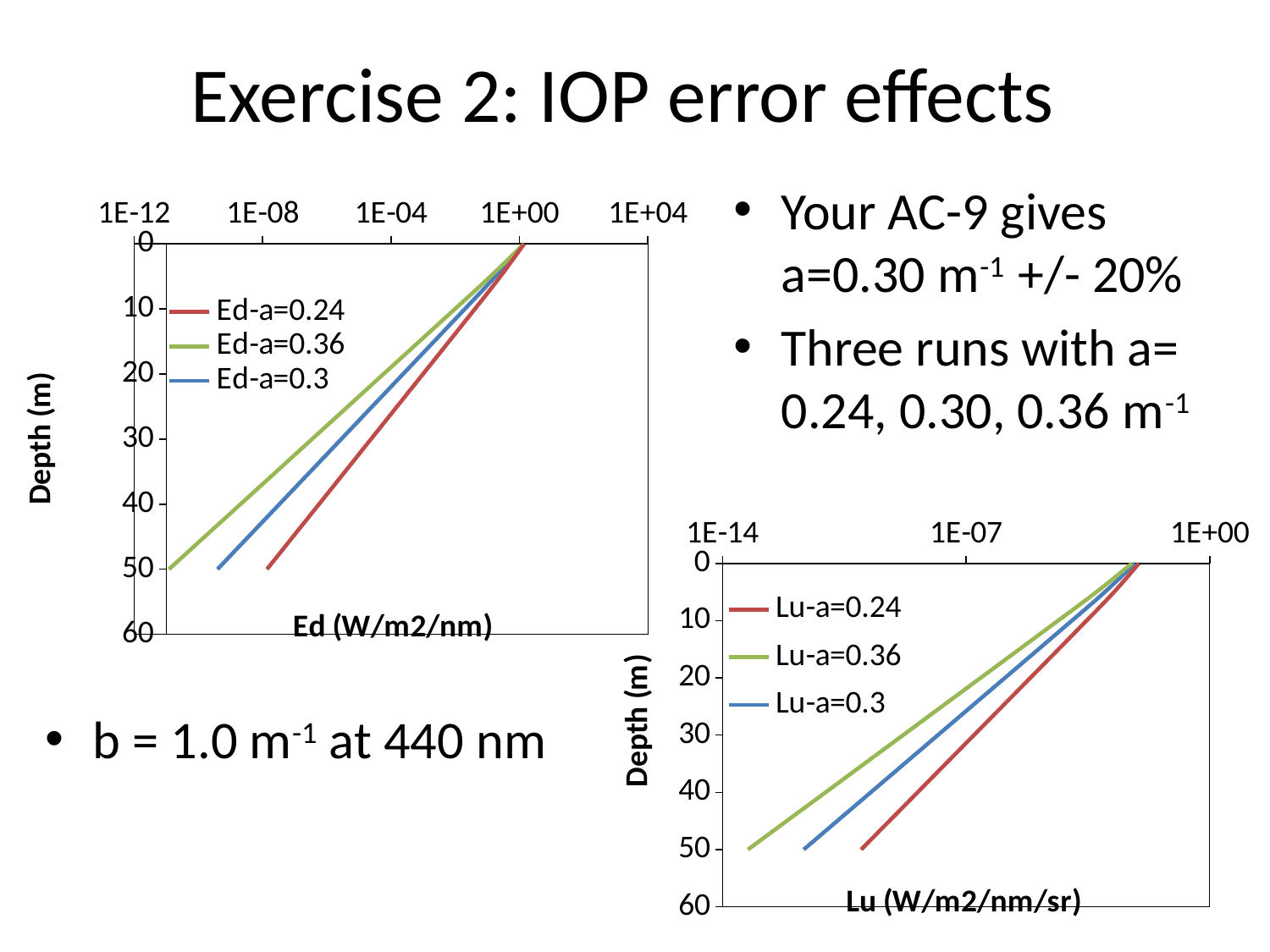
What is the y-axis title of the right chart (Lu)? Depth (m) In the left chart (Ed), which series has the lowest Ed value at 50 m depth? Ed-a=0.36 In the left chart (Ed), is the Ed value for Ed-a=0.24 at 50 m depth greater or less than 1E-04? less In the right chart (Lu), is the Lu value for Lu-a=0.24 at 50 m depth greater or less than 1E-07? less In the right chart (Lu), which series has the lowest Lu value at 50 m depth? Lu-a=0.36 In the right chart (Lu), does Lu increase or decrease as depth increases from 0 to 50 m? decrease In the left chart (Ed), which series is drawn in green? Ed-a=0.36 What kind of chart is the left chart titled Ed (W/m2/nm)? line chart How many series does the legend of the left chart (Ed) list? 3 In the left chart (Ed), does Ed increase or decrease as depth increases from 0 to 50 m? decrease In the left chart (Ed), which series has the highest Ed value at 50 m depth? Ed-a=0.24 How many series does the legend of the right chart (Lu) list? 3